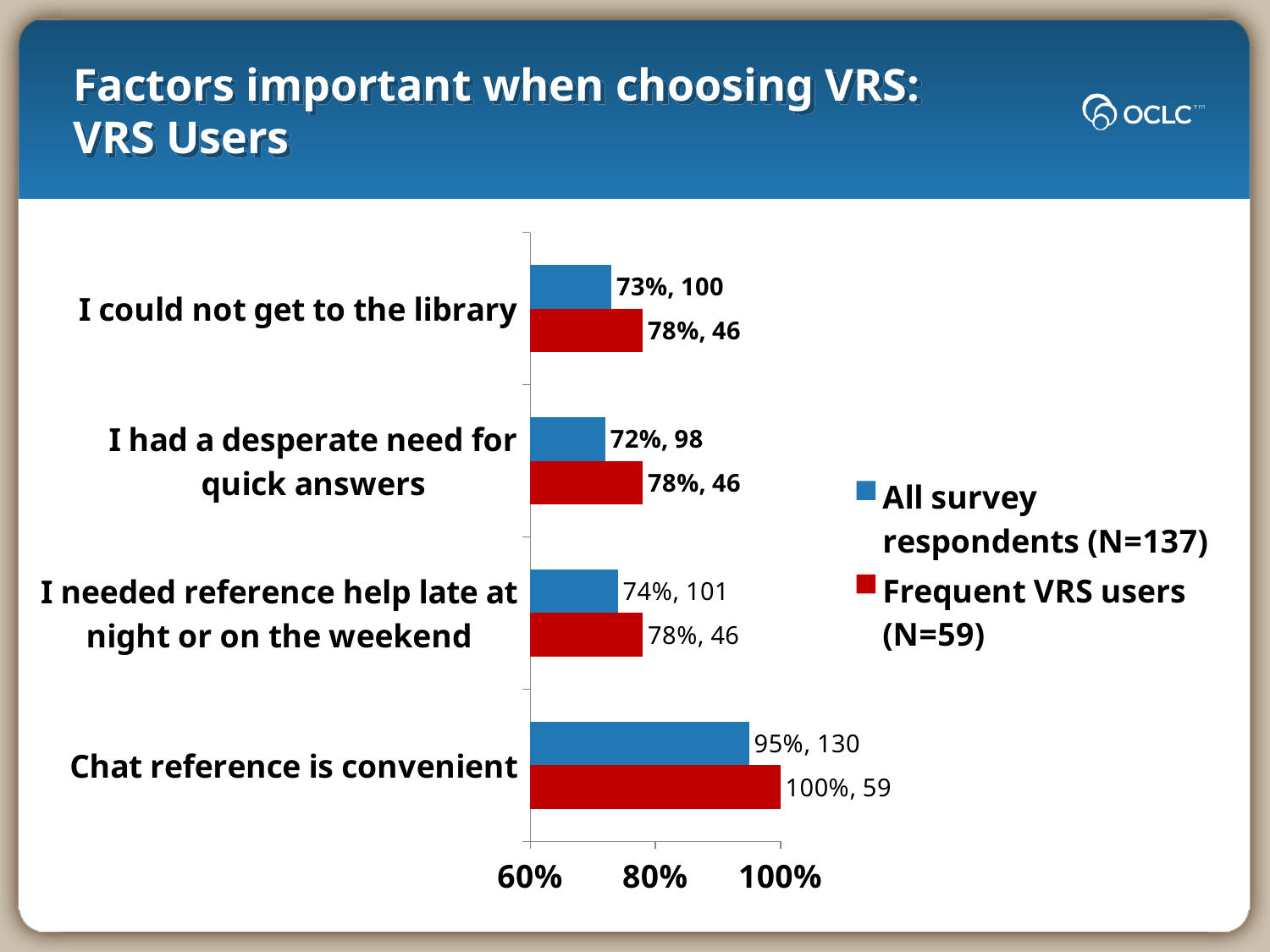
Which factor has the highest percentage among all survey respondents? Chat reference is convenient For 'I needed reference help late at night or on the weekend', which group has the higher percentage: all survey respondents or frequent VRS users? Frequent VRS users What percentage of frequent VRS users chose 'I could not get to the library'? 78% How many factors are shown on the chart? 4 What kind of chart is shown on the slide? Bar chart What percentage of all survey respondents chose 'Chat reference is convenient'? 95% What is the data label for frequent VRS users on 'Chat reference is convenient'? 100%, 59 How many series does the legend list? 2 How many all survey respondents chose 'I had a desperate need for quick answers'? 98 Which factor has the lowest percentage among all survey respondents? I had a desperate need for quick answers Is the value for all survey respondents on 'I could not get to the library' greater or less than 80%? less What is the difference in percentage points between frequent VRS users and all survey respondents for 'Chat reference is convenient'? 5